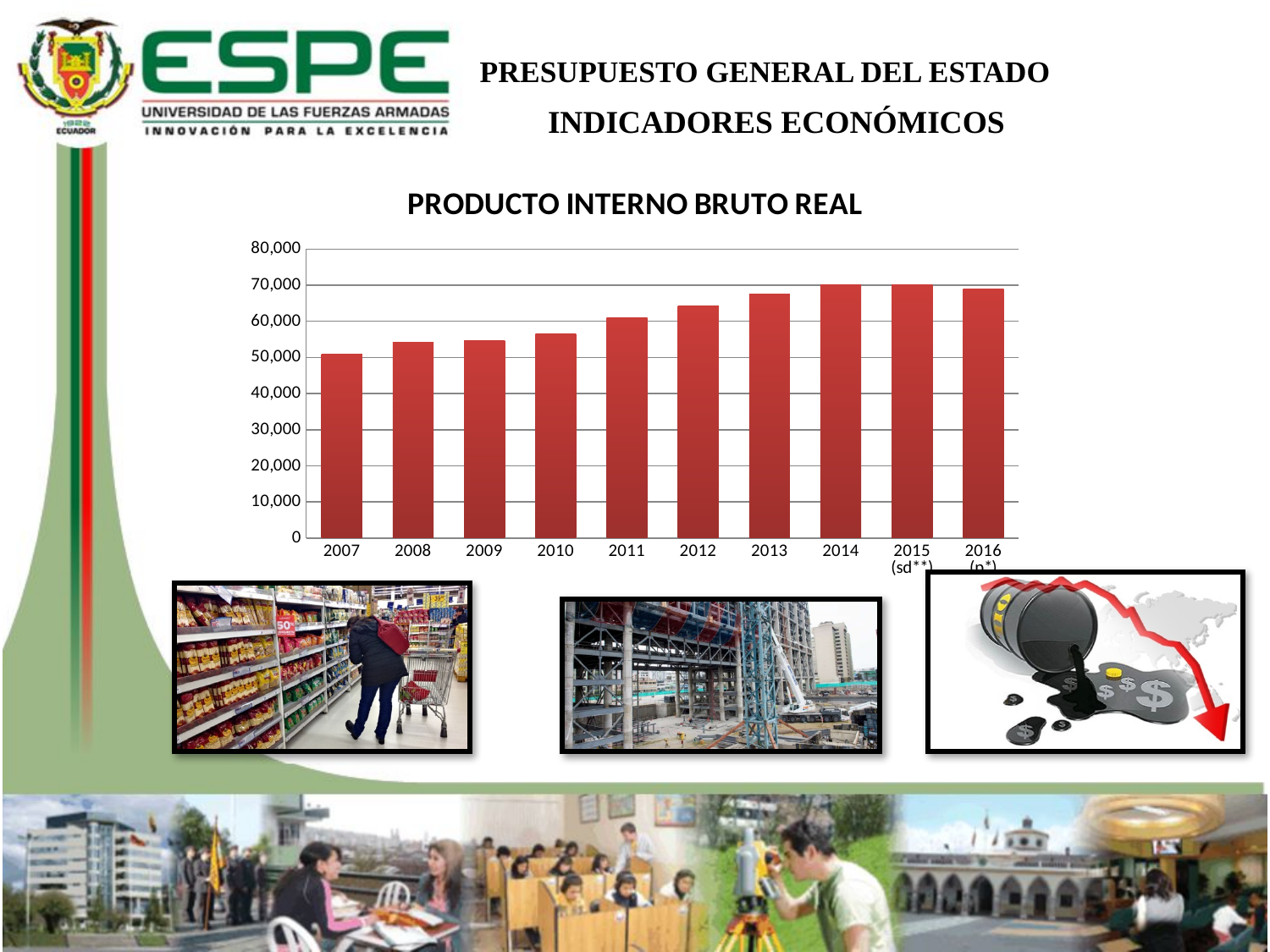
Is the value for 2008 greater or less than 50,000? greater Is the value for 2012 greater or less than 60,000? greater Is the value for 2014 greater or less than 60,000? greater Do the values generally rise or fall from 2007 to 2014? rise Which year has the lowest value in the chart? 2007 Which year has the larger value, 2010 or 2011? 2011 Which year has the larger value, 2009 or 2012? 2012 What kind of chart is shown on the slide? bar chart What is the title of the chart? PRODUCTO INTERNO BRUTO REAL How many years (bars) are plotted in the chart? 10